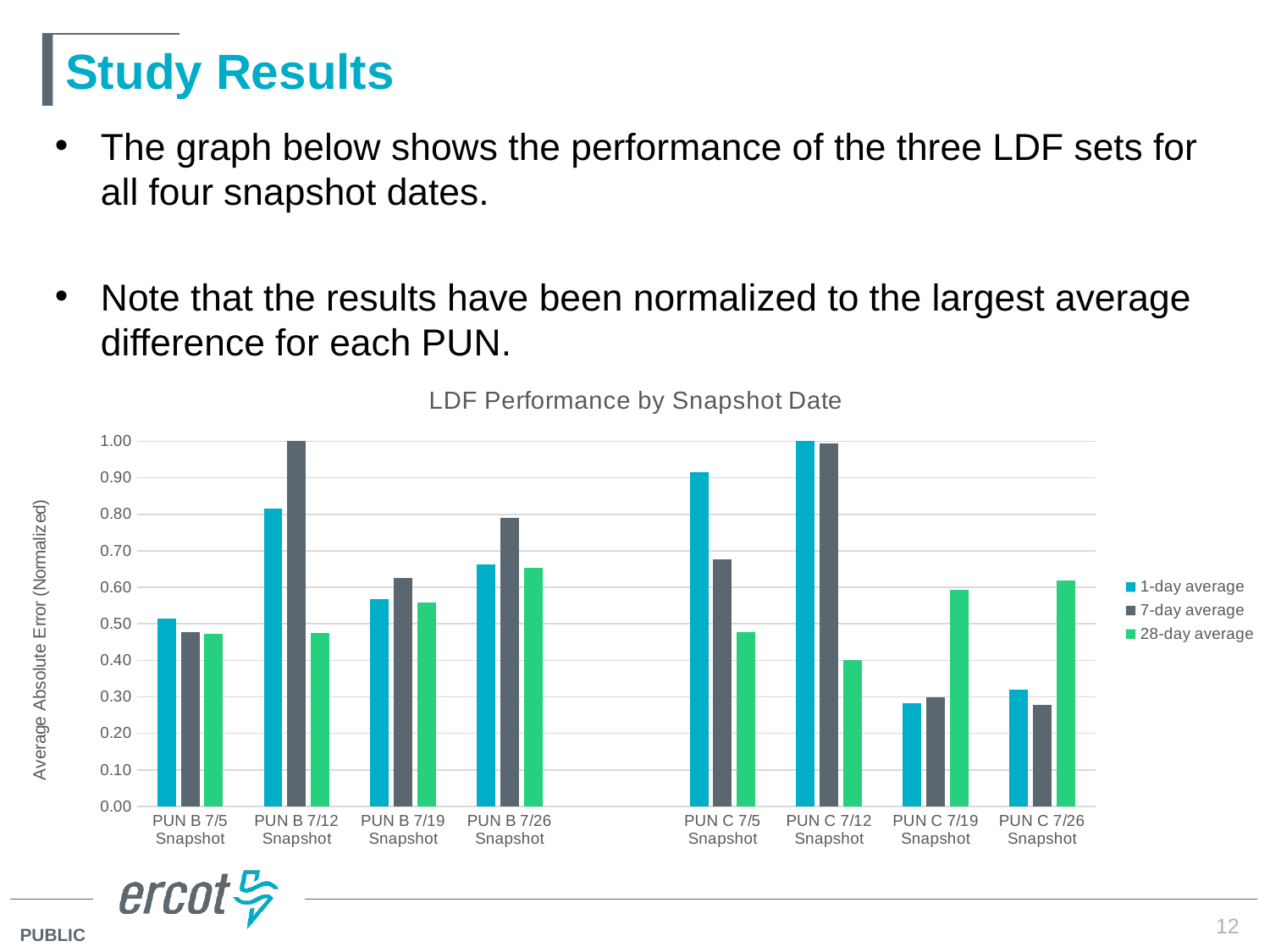
Which snapshot has the lowest 1-day average value? PUN C 7/19 Snapshot For PUN B 7/12 Snapshot, which is larger: the 7-day average or the 28-day average? 7-day average Which snapshot has the highest 1-day average value? PUN C 7/12 Snapshot Is the 1-day average value for PUN C 7/5 Snapshot greater or less than 0.80? greater What is the 1-day average value for PUN C 7/12 Snapshot? 1.00 What kind of chart is shown on the slide? Bar chart How many series does the legend list? 3 For PUN C 7/19 Snapshot, which is larger: the 1-day average or the 28-day average? 28-day average How many snapshot categories are shown on the x axis? 8 What is the 7-day average value for PUN B 7/12 Snapshot? 1.00 What is the title of the chart? LDF Performance by Snapshot Date Is the 1-day average value for PUN C 7/19 Snapshot greater or less than 0.40? less